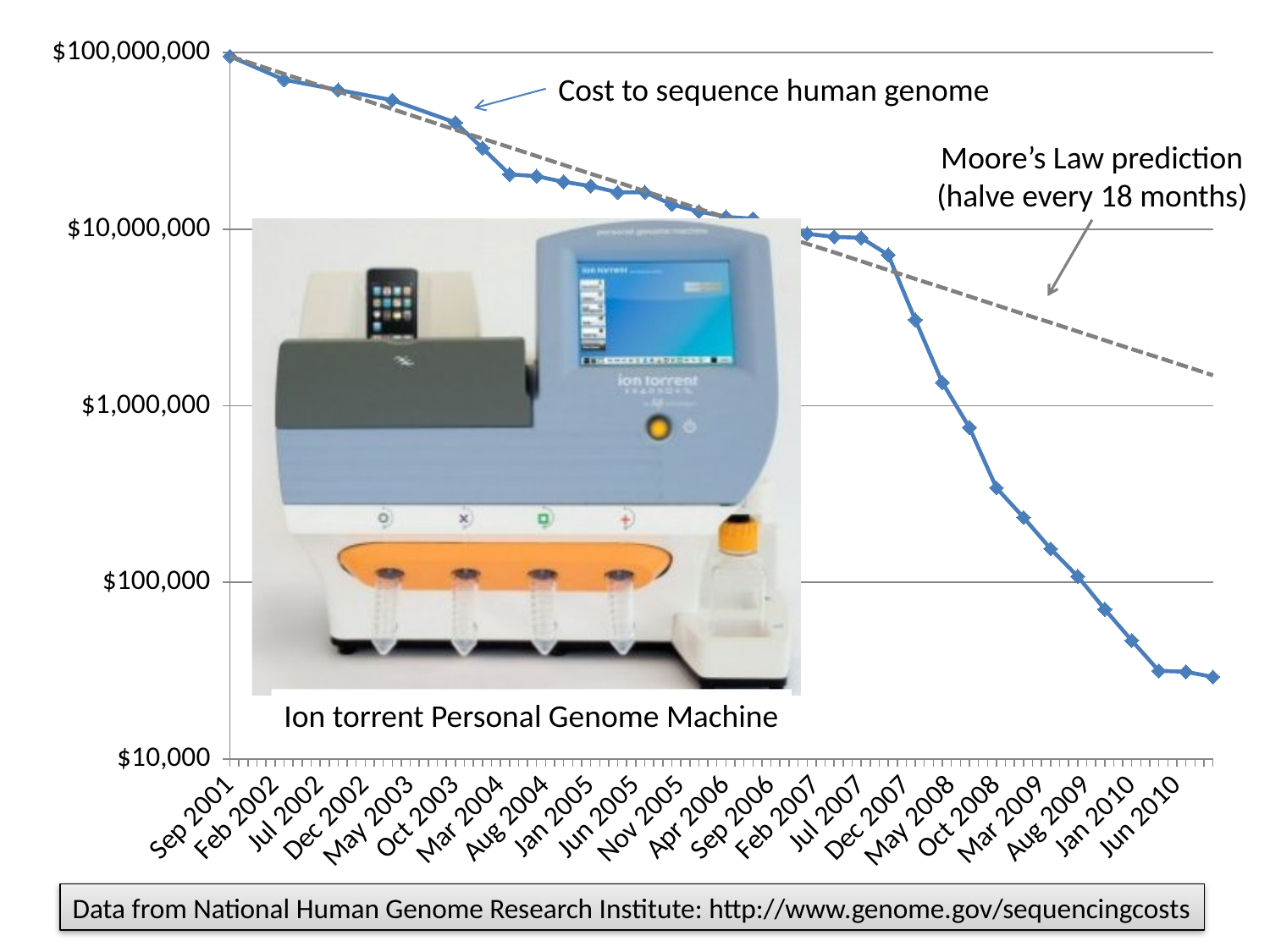
Is the Moore's Law prediction at the right end of the chart greater or less than $1,000,000? greater How many lines are plotted on the chart? 2 Is the cost to sequence a human genome in Sep 2001 greater or less than $10,000,000? greater According to the annotation, how often does the Moore's Law prediction halve the cost? every 18 months Which is higher at the right end of the chart: the actual cost to sequence a human genome or the Moore's Law prediction? Moore's Law prediction Is the cost to sequence a human genome in Jun 2010 greater or less than $100,000? less What is the source of the data cited at the bottom of the slide? National Human Genome Research Institute: http://www.genome.gov/sequencingcosts Does the cost to sequence a human genome rise or fall from Sep 2001 to Jun 2010? fall What kind of chart is shown on the slide? line chart Which is larger: the cost to sequence a human genome in Sep 2001 or in Jun 2010? Sep 2001